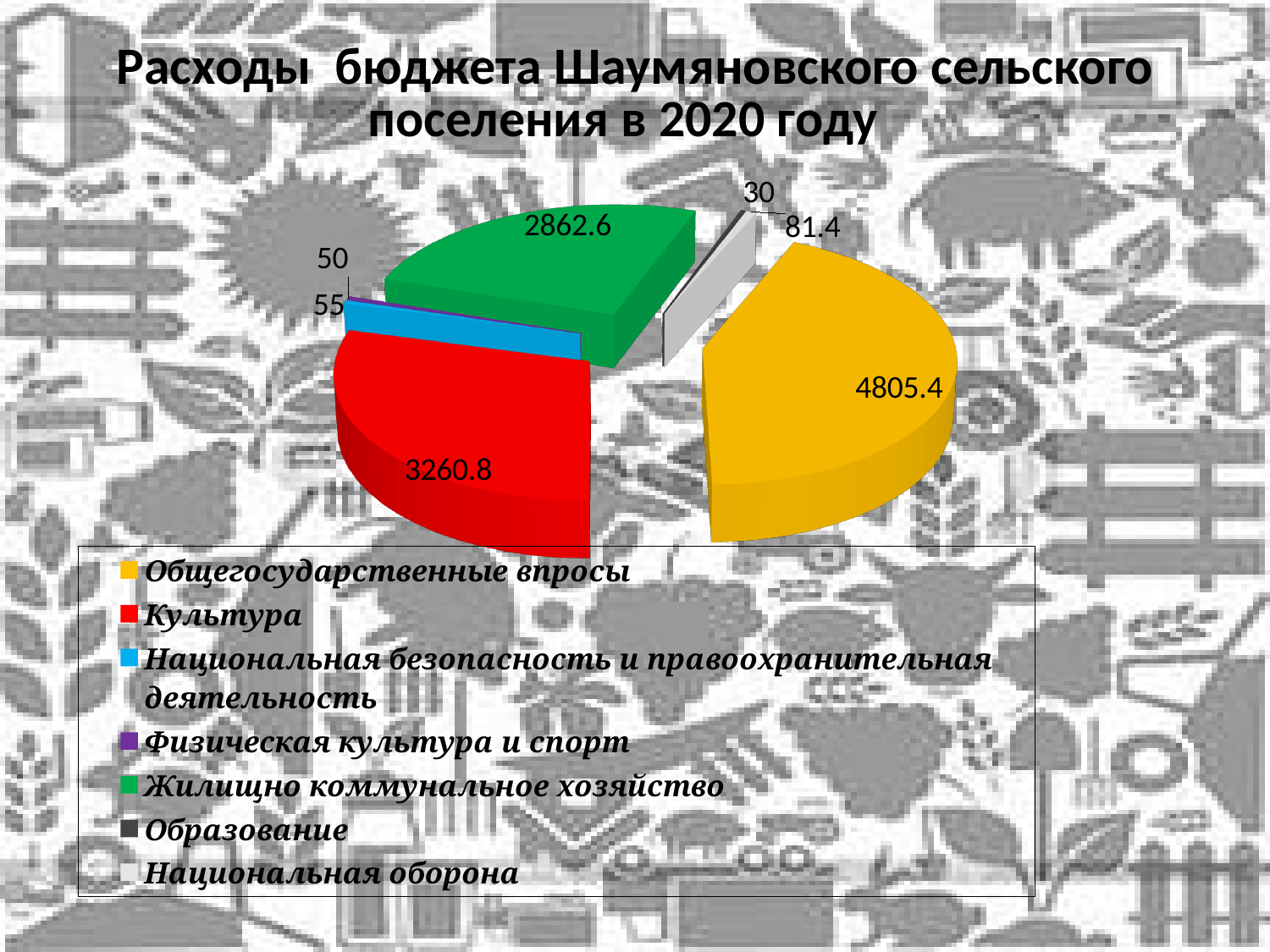
Which category has the smallest slice of the pie? Образование How many categories does the pie chart have? 7 What is the value for Национальная оборона? 81.4 What is the difference between the values for Национальная безопасность и правоохранительная деятельность and Физическая культура и спорт? 5 What is the value for Общегосударственные впросы? 4805.4 What kind of chart is shown on the slide? Pie chart What is the value for Культура? 3260.8 What is the title of the slide's chart? Расходы бюджета Шаумяновского сельского поселения в 2020 году What is the value for Жилищно коммунальное хозяйство? 2862.6 What is the difference between the values for Общегосударственные впросы and Культура? 1544.6 Which is larger, the value for Культура or the value for Жилищно коммунальное хозяйство? Культура Which category has the largest slice of the pie? Общегосударственные впросы